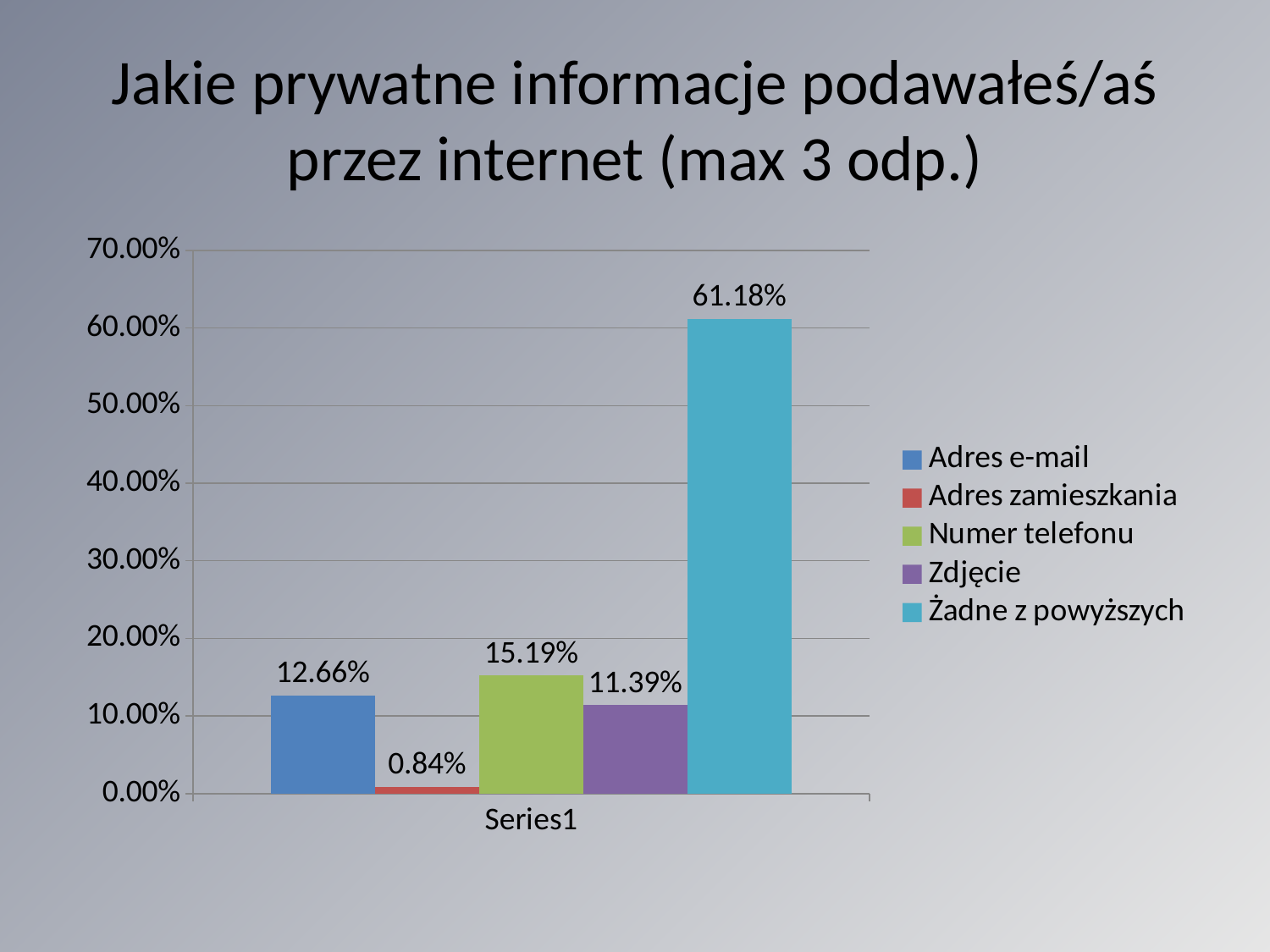
Which category has the highest value? Żadne z powyższych Which is larger, the value for Adres e-mail or the value for Zdjęcie? Adres e-mail What is the value for Numer telefonu? 15.19% What is the value for Adres e-mail? 12.66% What is the value for Żadne z powyższych? 61.18% What is the difference between the values for Żadne z powyższych and Numer telefonu? 45.99% What kind of chart is shown on the slide? Bar chart What is the value for Adres zamieszkania? 0.84% Which category has the lowest value? Adres zamieszkania How many series does the legend list? 5 What is the title of the chart? Jakie prywatne informacje podawałeś/aś przez internet (max 3 odp.) What is the value for Zdjęcie? 11.39%